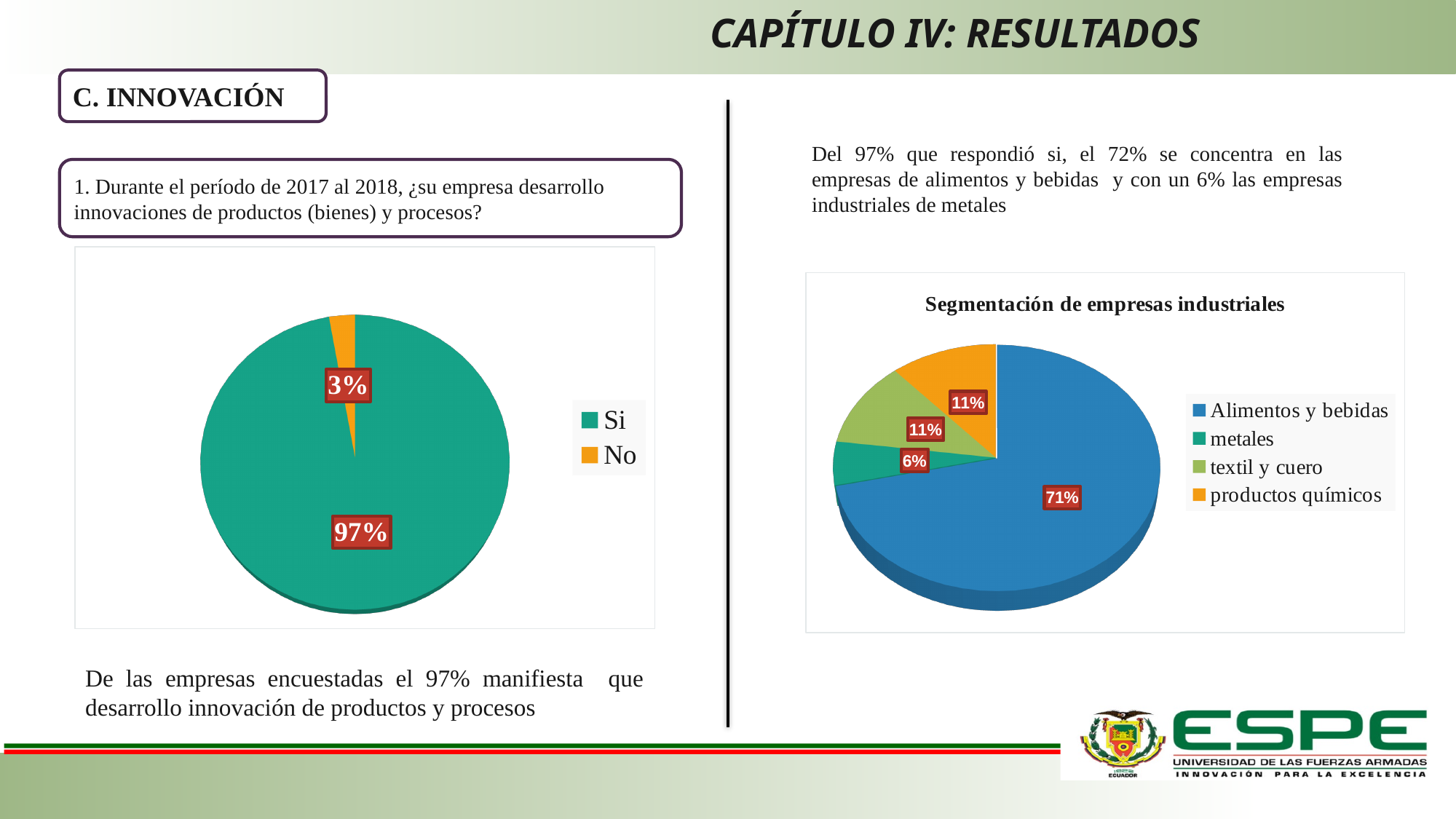
What type of chart is the left chart on the slide? Pie chart In the chart titled "Segmentación de empresas industriales", what is the share for "metales"? 6% In the chart titled "Segmentación de empresas industriales", which category has the smallest share? metales In the left pie chart, what is the difference in percentage points between "Si" and "No"? 94 In the chart titled "Segmentación de empresas industriales", what is the share for "textil y cuero"? 11% In the left pie chart, what percentage of companies answered "No"? 3% In the chart titled "Segmentación de empresas industriales", how many categories does the legend list? 4 In the left pie chart, what percentage of companies answered "Si"? 97% In the chart titled "Segmentación de empresas industriales", which category has the largest share? Alimentos y bebidas In the chart titled "Segmentación de empresas industriales", what is the share for "Alimentos y bebidas"? 71% In the chart titled "Segmentación de empresas industriales", what is the difference in percentage points between "Alimentos y bebidas" and "metales"? 65 How many categories does the legend of the left pie chart list? 2